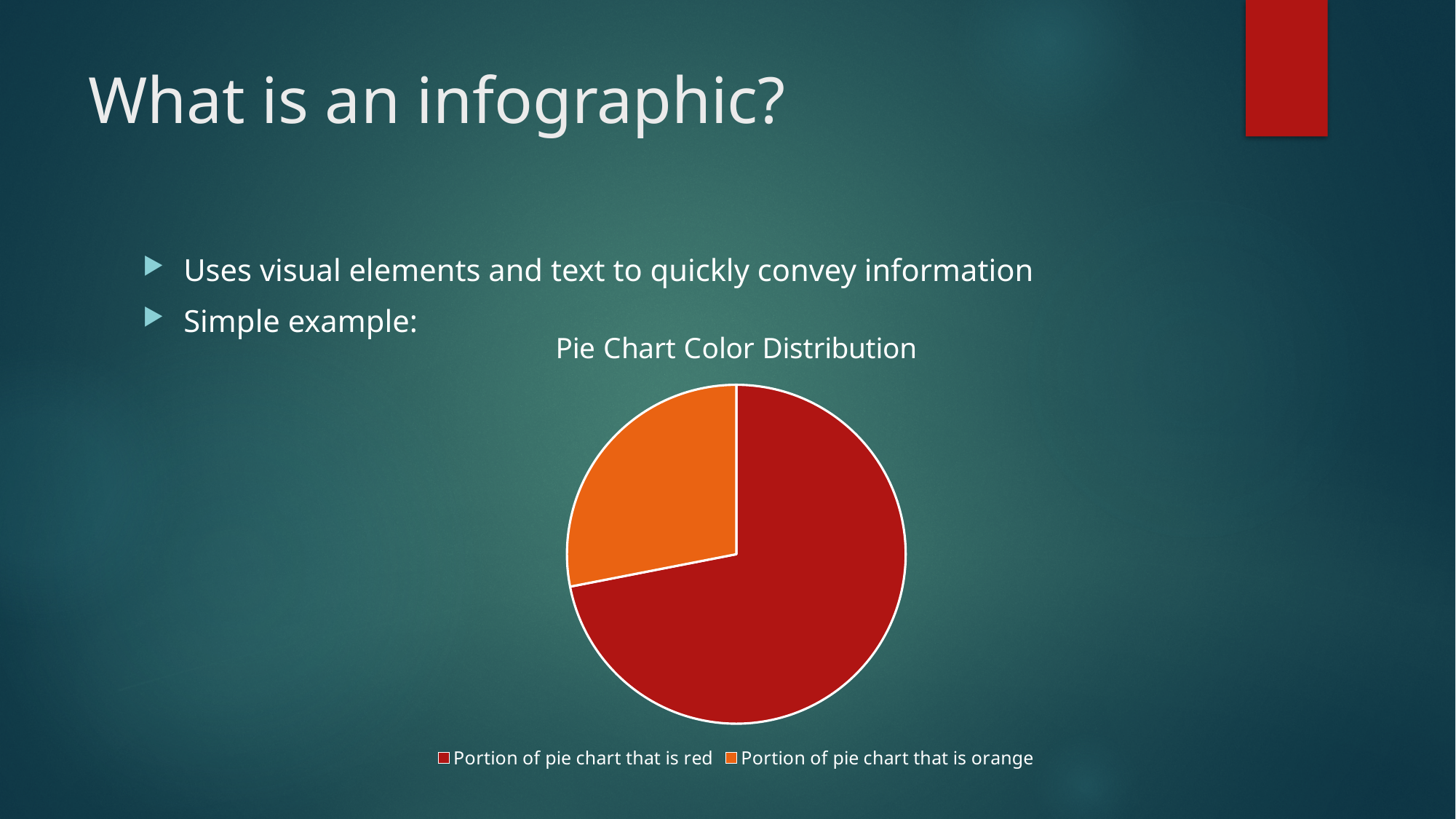
How many entries does the chart legend list? 2 How many slices does the pie chart have? 2 What is the title of the chart? Pie Chart Color Distribution Which slice is the smallest in the pie chart? Portion of pie chart that is orange What colour is used for the legend entry 'Portion of pie chart that is orange'? orange Which is larger: the portion of the pie chart that is red or the portion that is orange? Portion of pie chart that is red What kind of chart is shown on the slide? pie chart Which slice is the largest in the pie chart? Portion of pie chart that is red